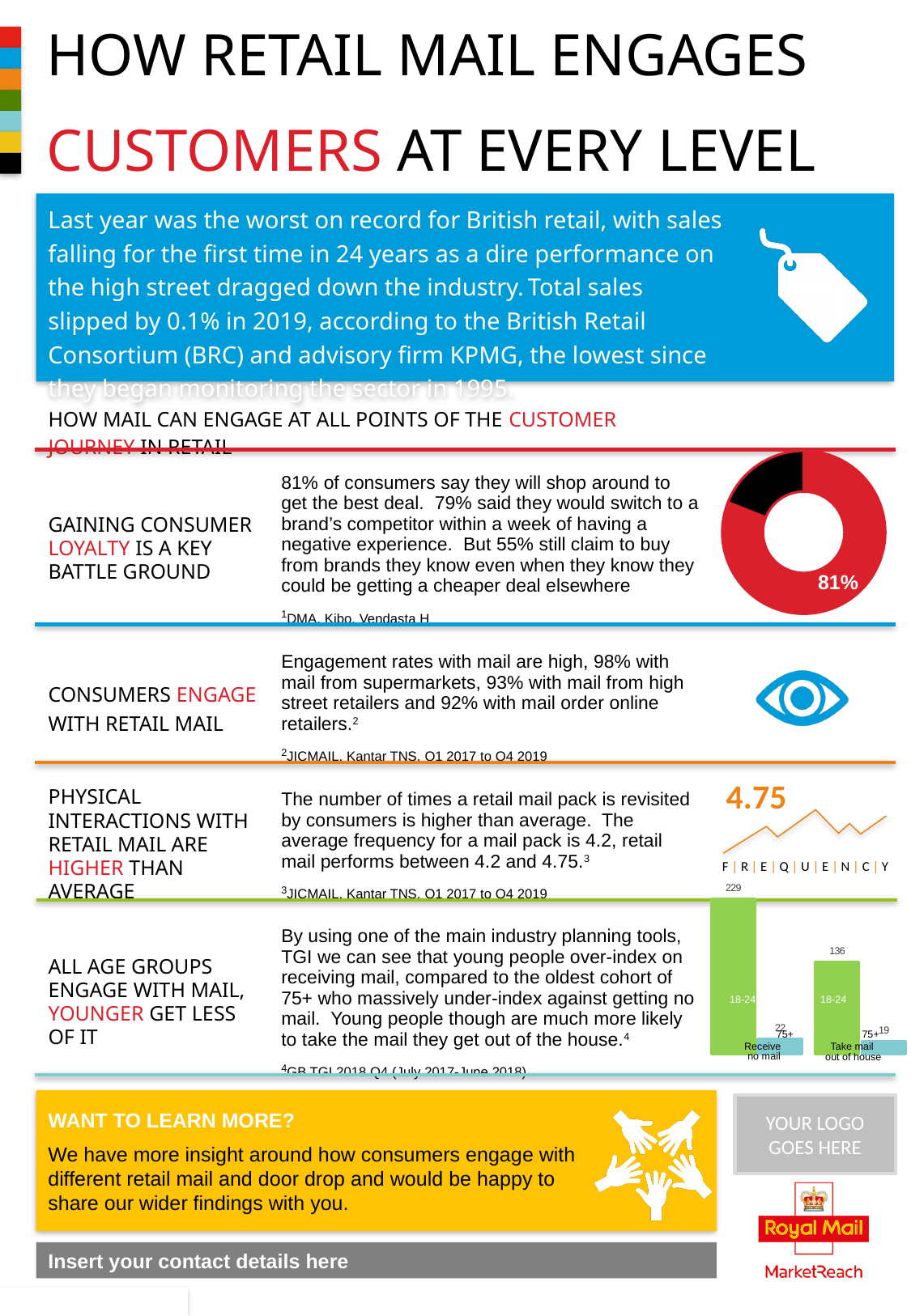
What percentage is labelled on the donut chart in the 'Gaining consumer loyalty' section? 81% In the bar chart at the bottom right, which bar has the highest value? 18-24, Receive no mail In the bar chart at the bottom right, what is the value for 18-24 under 'Receive no mail'? 229 In the bar chart at the bottom right, which is larger: the 18-24 value for 'Receive no mail' or the 18-24 value for 'Take mail out of house'? Receive no mail In the bar chart at the bottom right, what is the difference between the 18-24 and 75+ values under 'Receive no mail'? 207 In the bar chart at the bottom right, what is the value for 75+ under 'Receive no mail'? 22 What value is printed above the line chart in the 'Physical interactions with retail mail' section? 4.75 What kind of chart is shown next to the 'All age groups engage with mail' section? Bar chart In the bar chart at the bottom right, what is the value for 75+ under 'Take mail out of house'? 19 What kind of chart is shown next to the 'Gaining consumer loyalty is a key battle ground' section? Donut chart In the bar chart at the bottom right, what is the value for 18-24 under 'Take mail out of house'? 136 What colour is the 81% segment of the donut chart? Red